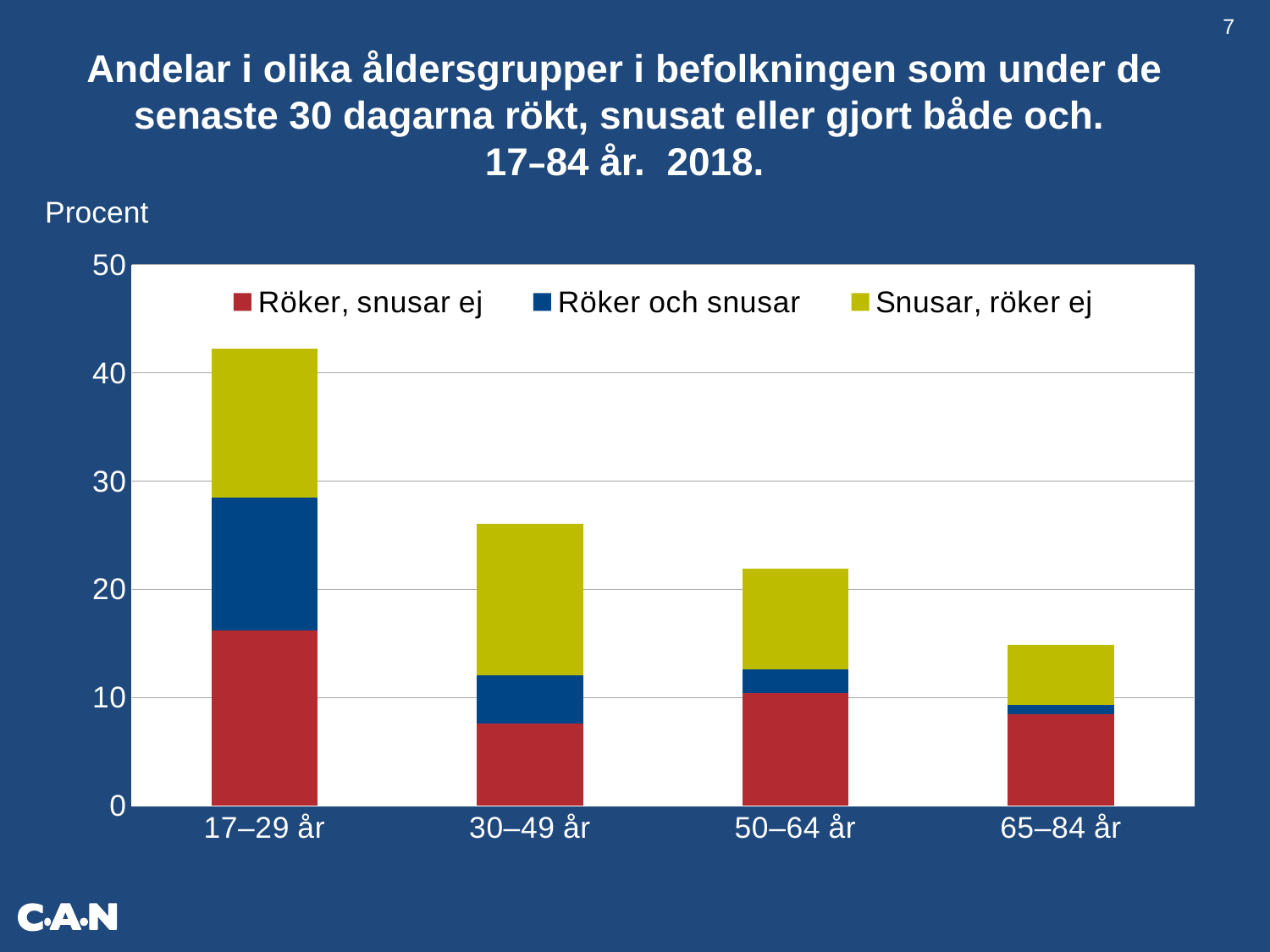
Is the 'Röker, snusar ej' segment for 17–29 år greater or less than 10? greater How many age groups are shown on the x axis? 4 Which has the larger total bar, 30–49 år or 50–64 år? 30–49 år Is the total bar for 65–84 år greater or less than 20? less Which age group has the highest total bar? 17–29 år Which age group has the lowest total bar? 65–84 år How many series does the legend list? 3 Do the total bar heights rise or fall as age group increases along the x axis? Fall Is the 'Röker, snusar ej' segment for 30–49 år greater or less than 10? less What kind of chart is shown on the slide? Stacked bar chart Which series is shown in yellow in the legend? Snusar, röker ej